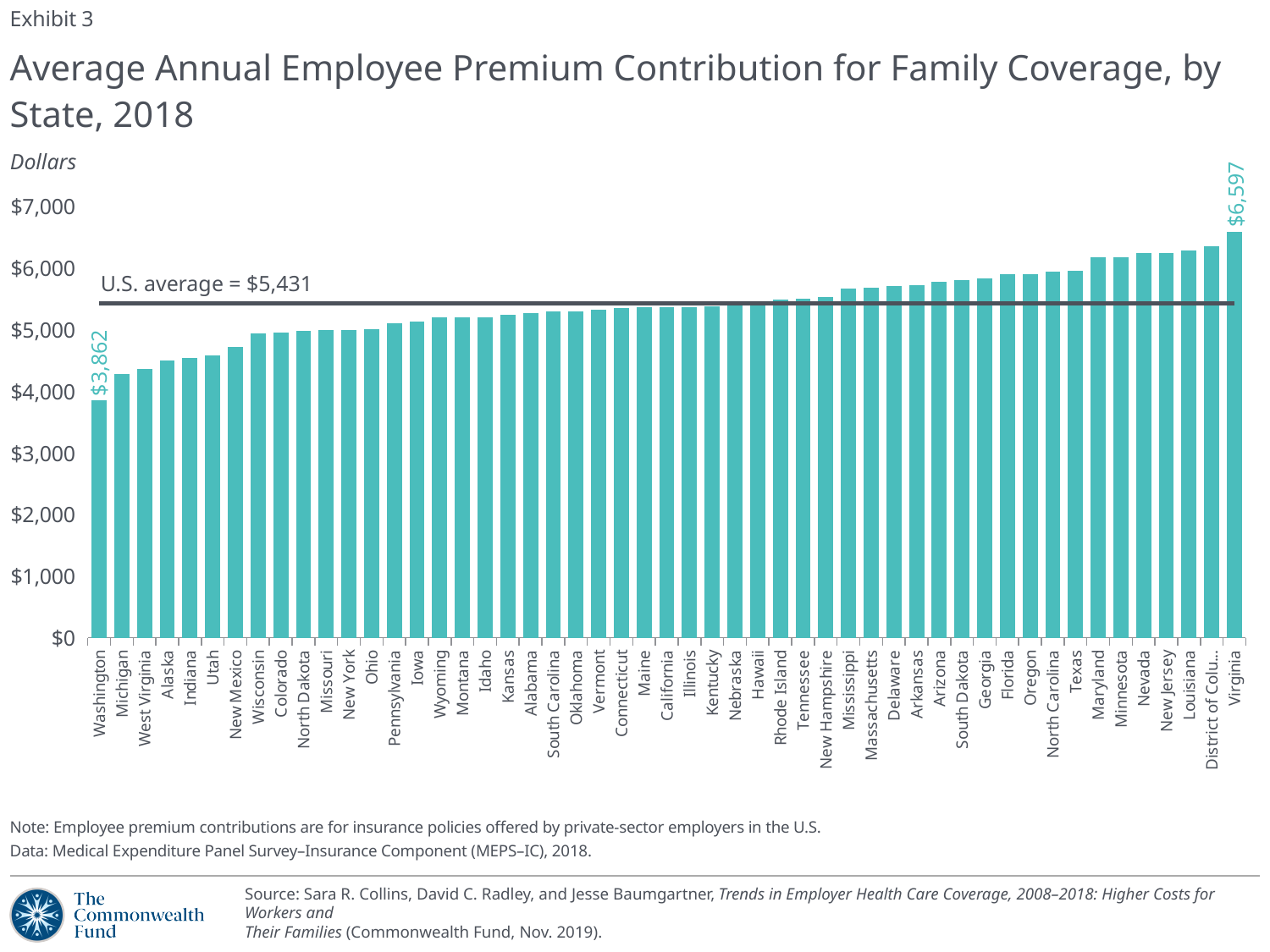
Is the value for Alaska greater or less than $5,000? less What is the difference between Virginia's and Washington's average annual employee premium contributions? $2,735 Is the value for Michigan greater or less than $5,000? less What is the average annual employee premium contribution for family coverage in Virginia? $6,597 How many states and districts are shown on the chart? 51 What kind of chart is shown on the slide? Bar chart Which state has the highest average annual employee premium contribution for family coverage? Virginia Is the value for Louisiana greater or less than $6,000? greater Which state has the lowest average annual employee premium contribution for family coverage? Washington What is the average annual employee premium contribution for family coverage in Washington? $3,862 What is the U.S. average employee premium contribution for family coverage shown on the chart? $5,431 Which has a larger average annual employee premium contribution, Texas or Michigan? Texas